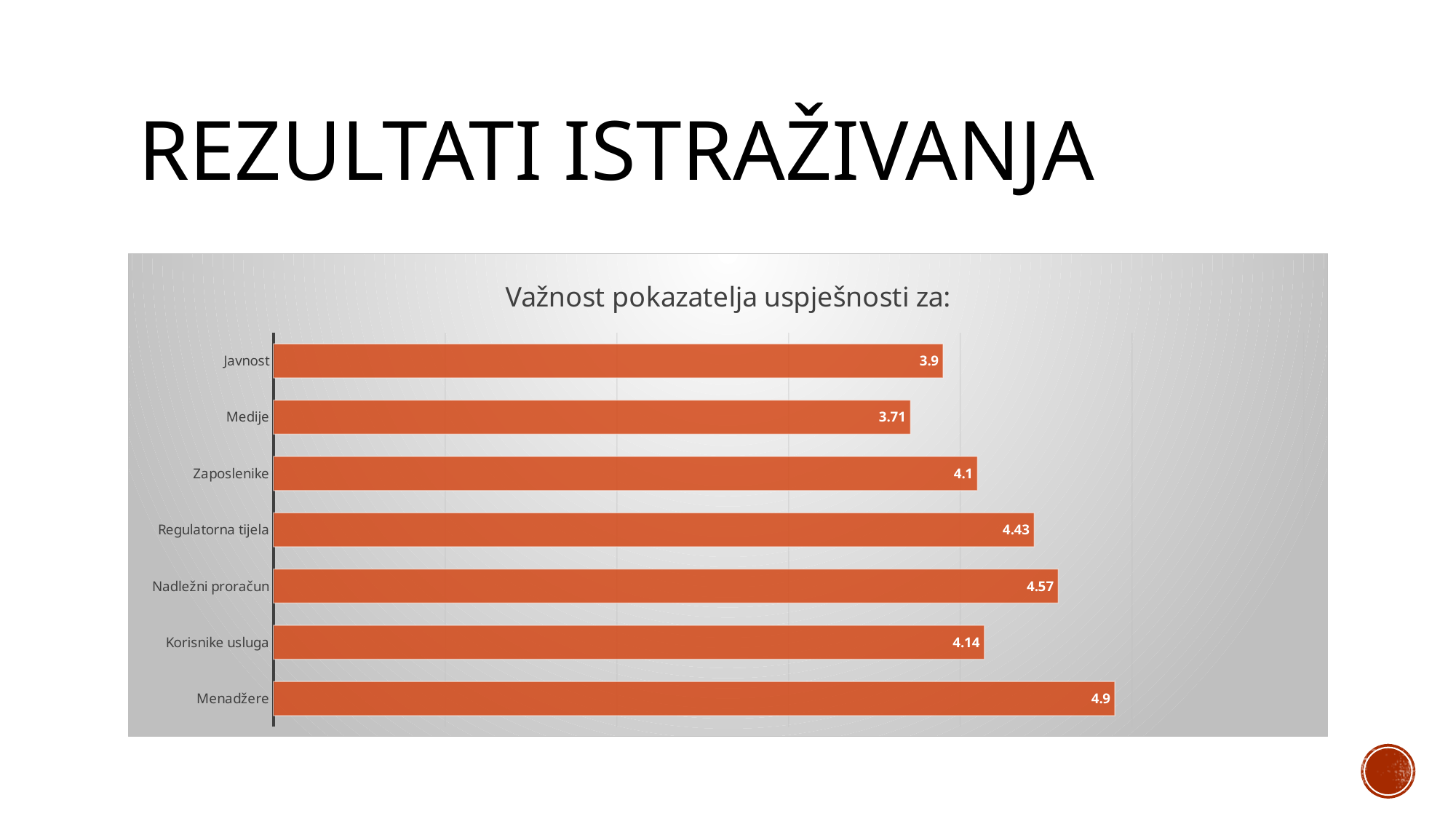
Which category has the lowest value? Medije What is the value for Menadžere? 4.9 Which is larger, the value for Javnost or the value for Zaposlenike? Zaposlenike What kind of chart is shown on the slide? Bar chart Which category has the highest value? Menadžere What is the difference between the values for Menadžere and Medije? 1.19 What is the value for Regulatorna tijela? 4.43 What is the value for Korisnike usluga? 4.14 What is the title of the chart? Važnost pokazatelja uspješnosti za: What is the value for Medije? 3.71 What is the difference between the values for Nadležni proračun and Zaposlenike? 0.47 How many categories are shown in the chart? 7